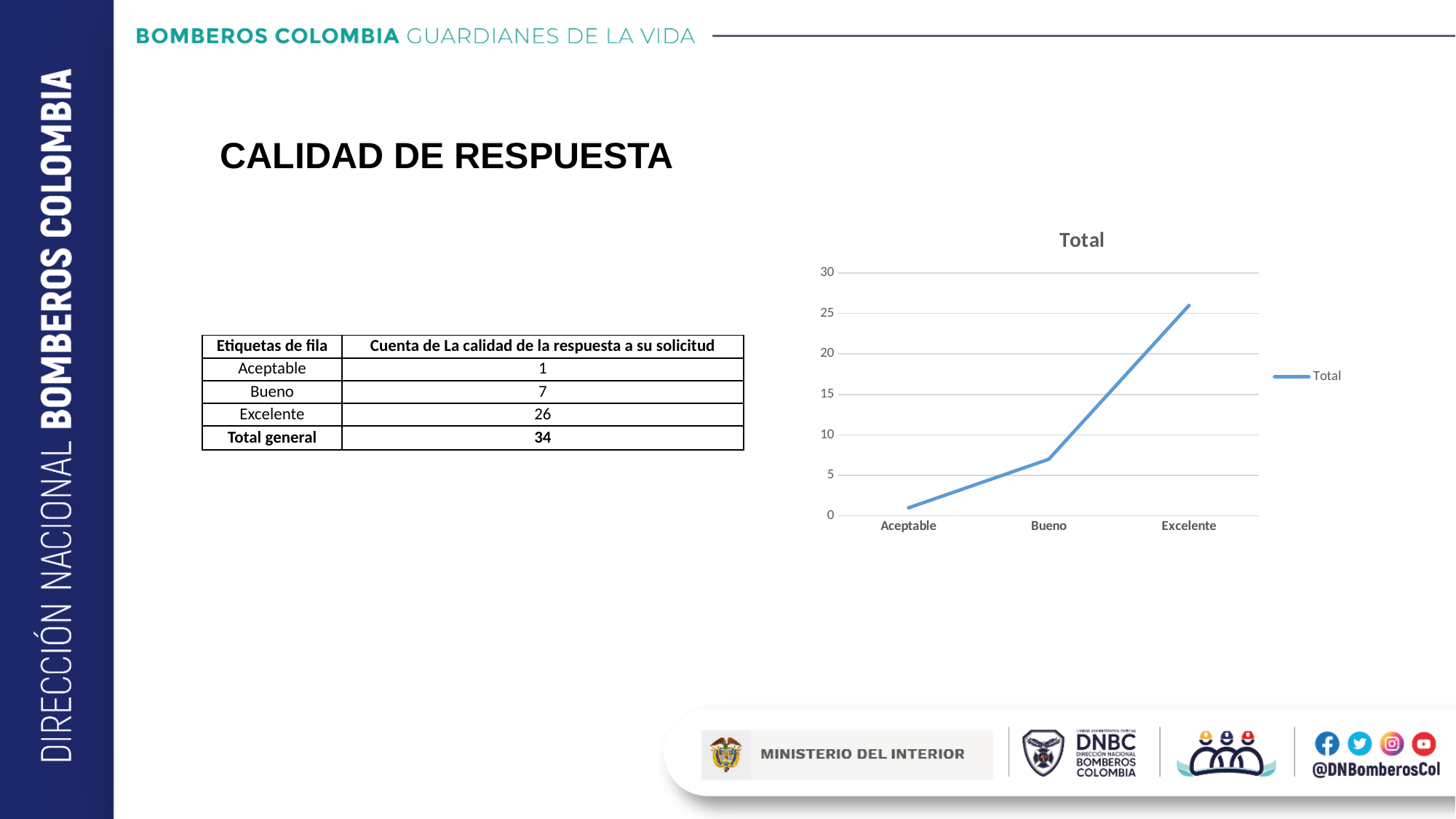
How many categories are plotted along the x axis of the chart? 3 Which is larger, the value for Bueno or the value for Aceptable? Bueno What kind of chart is shown on the slide? line chart Is the value for Bueno greater or less than 10? less Do the values rise or fall from Aceptable to Excelente along the x axis? rise What is the difference between the values for Excelente and Bueno? 19 Is the value for Excelente greater or less than 25? greater What is the title of the chart? Total Which category has the lowest value in the chart? Aceptable What is the value for Excelente? 26 Which category has the highest value in the chart? Excelente How many series does the chart legend list? 1